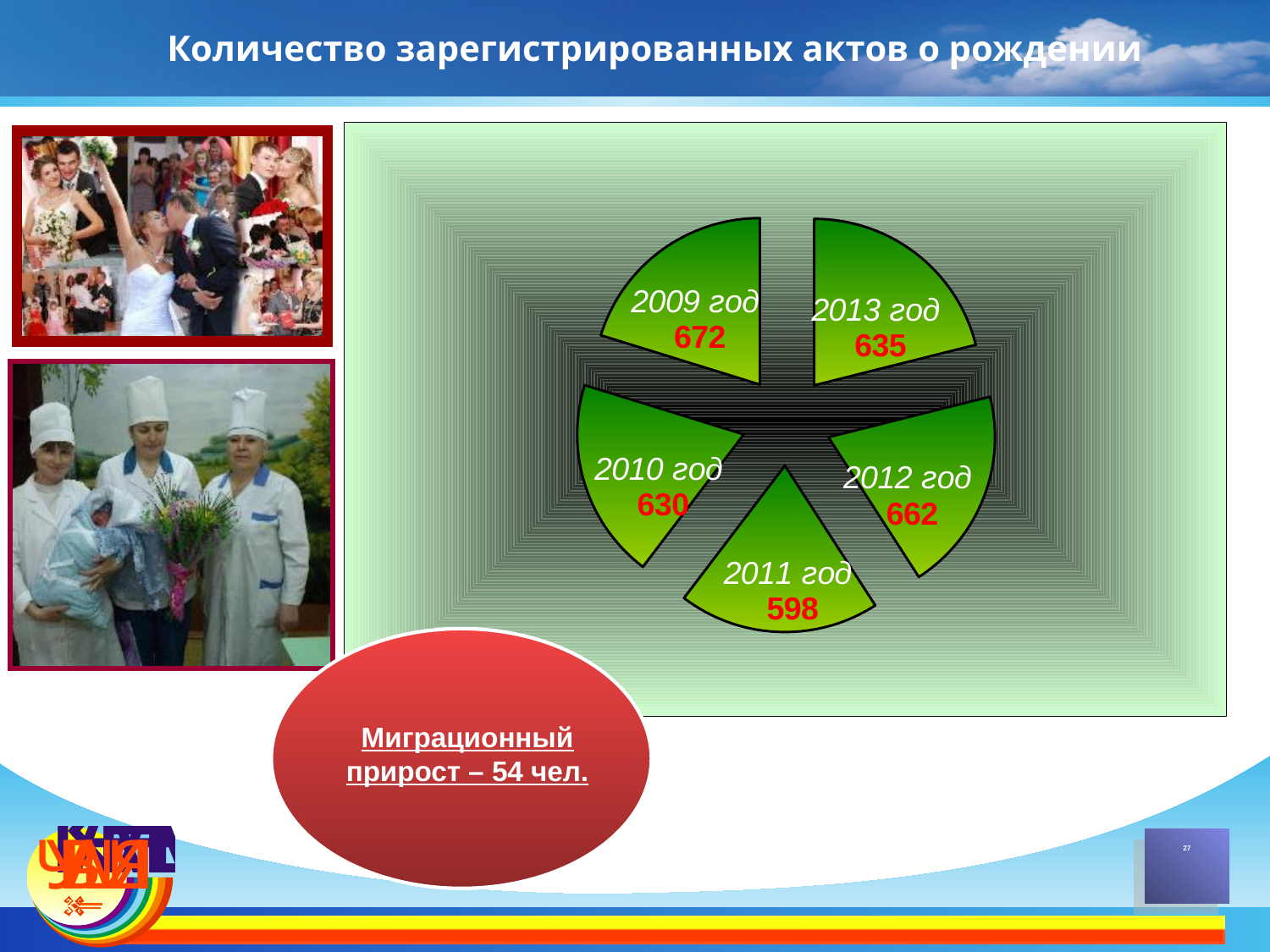
What is the total of all five values in the pie chart? 3197 What is the value for 2013 год? 635 Which year has the highest value in the pie chart? 2009 год What is the title of the chart on the slide? Количество зарегистрированных актов о рождении How many slices does the pie chart have? 5 What is the value for 2011 год? 598 What is the value for 2012 год? 662 What type of chart is shown on the slide? pie chart Which is larger, the value for 2010 год or the value for 2012 год? 2012 год Which year has the lowest value in the pie chart? 2011 год What is the value for 2009 год? 672 What is the difference between the values for 2009 год and 2011 год? 74